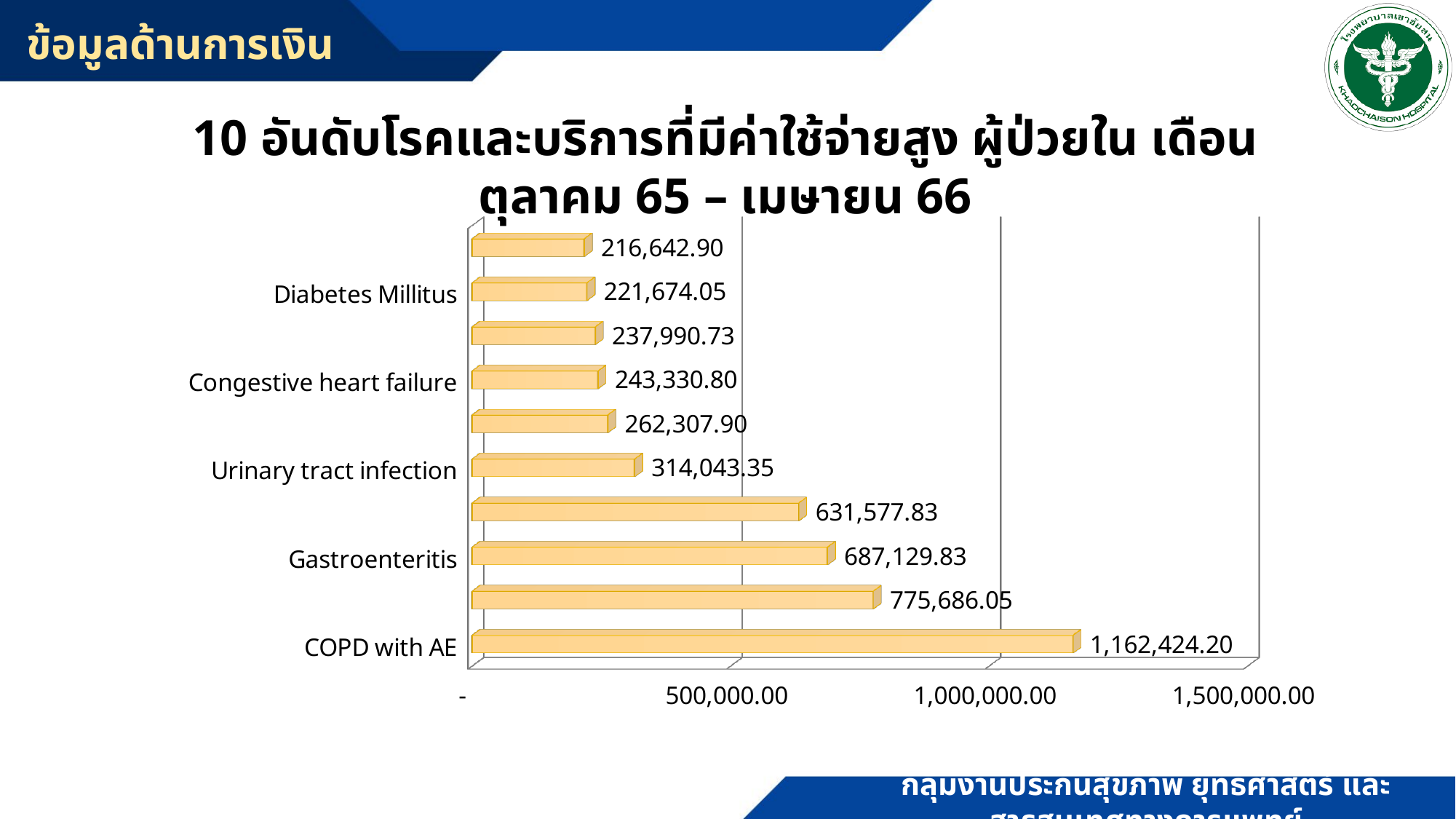
What is the value for Urinary tract infection? 314,043.35 What is the smallest value shown on the chart? 216,642.90 What is the value for Diabetes Millitus? 221,674.05 How many bars are shown on the chart? 10 What is the value for Gastroenteritis? 687,129.83 What is the value for Congestive heart failure? 243,330.80 Which is larger, the value for Gastroenteritis or the value for Urinary tract infection? Gastroenteritis What is the difference between the values for Urinary tract infection and Congestive heart failure? 70,712.55 Is the value for Gastroenteritis greater or less than 500,000.00? greater What is the difference between the values for COPD with AE and Gastroenteritis? 475,294.37 Which category has the highest value? COPD with AE What is the value for COPD with AE? 1,162,424.20